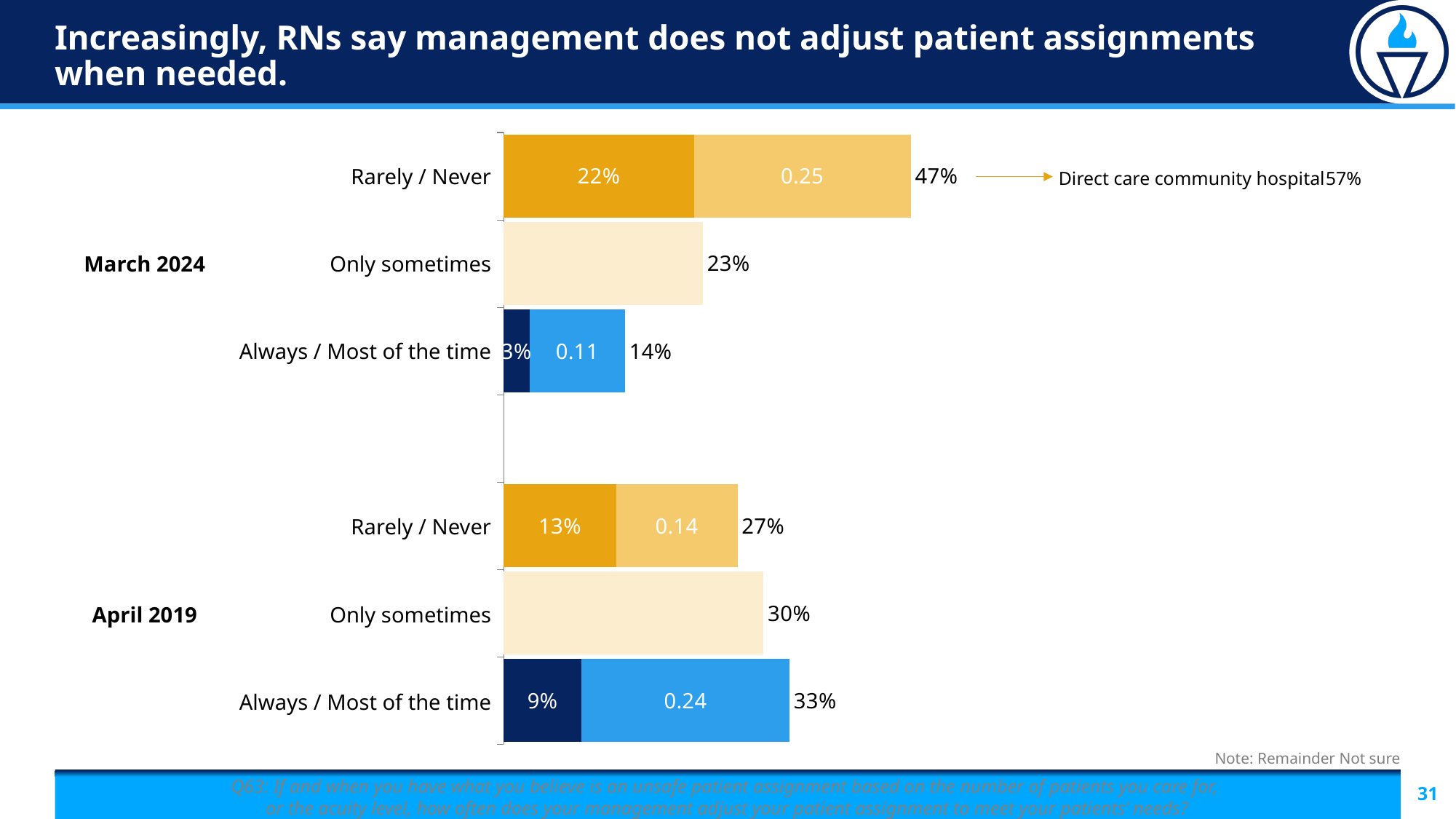
What is the total for Rarely / Never in March 2024? 47% What is the value of the dark blue segment for Always / Most of the time in April 2019? 9% What is the value for Only sometimes in April 2019? 30% What is the total for Rarely / Never in April 2019? 27% What is the total for Always / Most of the time in March 2024? 14% Which response has the lowest total in April 2019? Rarely / Never Which is larger: Always / Most of the time in March 2024 or in April 2019? April 2019 What kind of chart is shown on the slide? Stacked bar chart Which response has the highest total in March 2024? Rarely / Never What is the difference between the Rarely / Never totals for March 2024 and April 2019? 20 percentage points What percentage is given for Direct care community hospital in the annotation next to the March 2024 Rarely / Never bar? 57% What is the value of the darker orange segment for Rarely / Never in March 2024? 22%